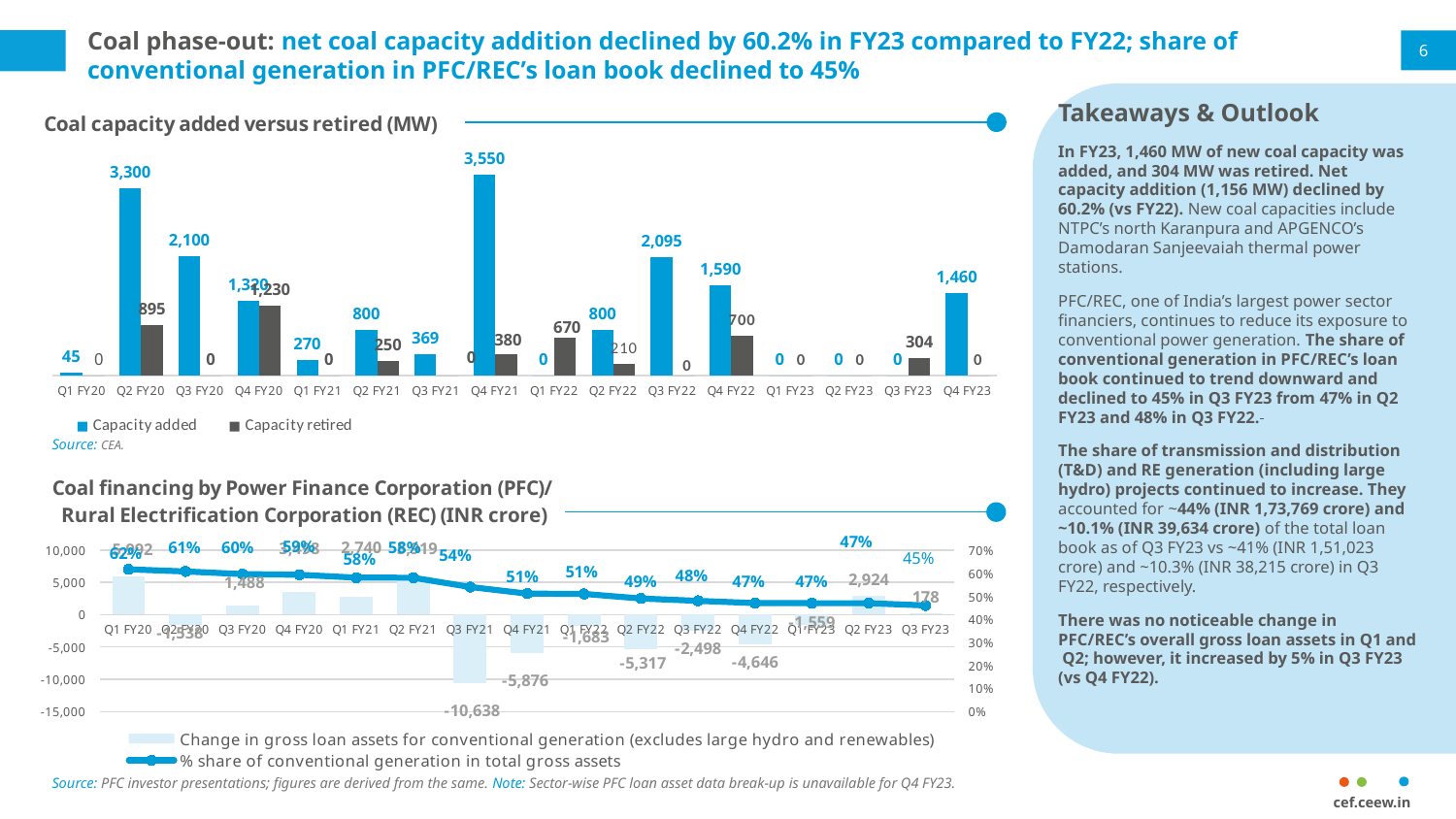
In the 'Coal financing by PFC/REC (INR crore)' chart, which quarter had the lowest change in gross loan assets for conventional generation? Q3 FY21 In the 'Coal capacity added versus retired (MW)' chart, what was the capacity added in Q4 FY23? 1,460 How many series does the legend of the 'Coal capacity added versus retired (MW)' chart list? 2 How many quarters are shown on the x axis of the 'Coal capacity added versus retired (MW)' chart? 16 In the 'Coal capacity added versus retired (MW)' chart, which is larger in Q1 FY22: capacity added or capacity retired? Capacity retired In the 'Coal capacity added versus retired (MW)' chart, what was the capacity retired in Q3 FY23? 304 What kind of chart is the 'Coal capacity added versus retired (MW)' chart? Bar chart In the 'Coal financing by PFC/REC (INR crore)' chart, what was the % share of conventional generation in total gross assets in Q3 FY23? 45% In the 'Coal capacity added versus retired (MW)' chart, which quarter had the highest capacity added? Q4 FY21 In the 'Coal capacity added versus retired (MW)' chart, which quarter had the highest capacity retired? Q4 FY20 In the 'Coal capacity added versus retired (MW)' chart, what is the difference between capacity added and capacity retired in Q2 FY20? 2,405 In the 'Coal financing by PFC/REC (INR crore)' chart, does the % share of conventional generation rise or fall from Q1 FY20 to Q3 FY23? Fall